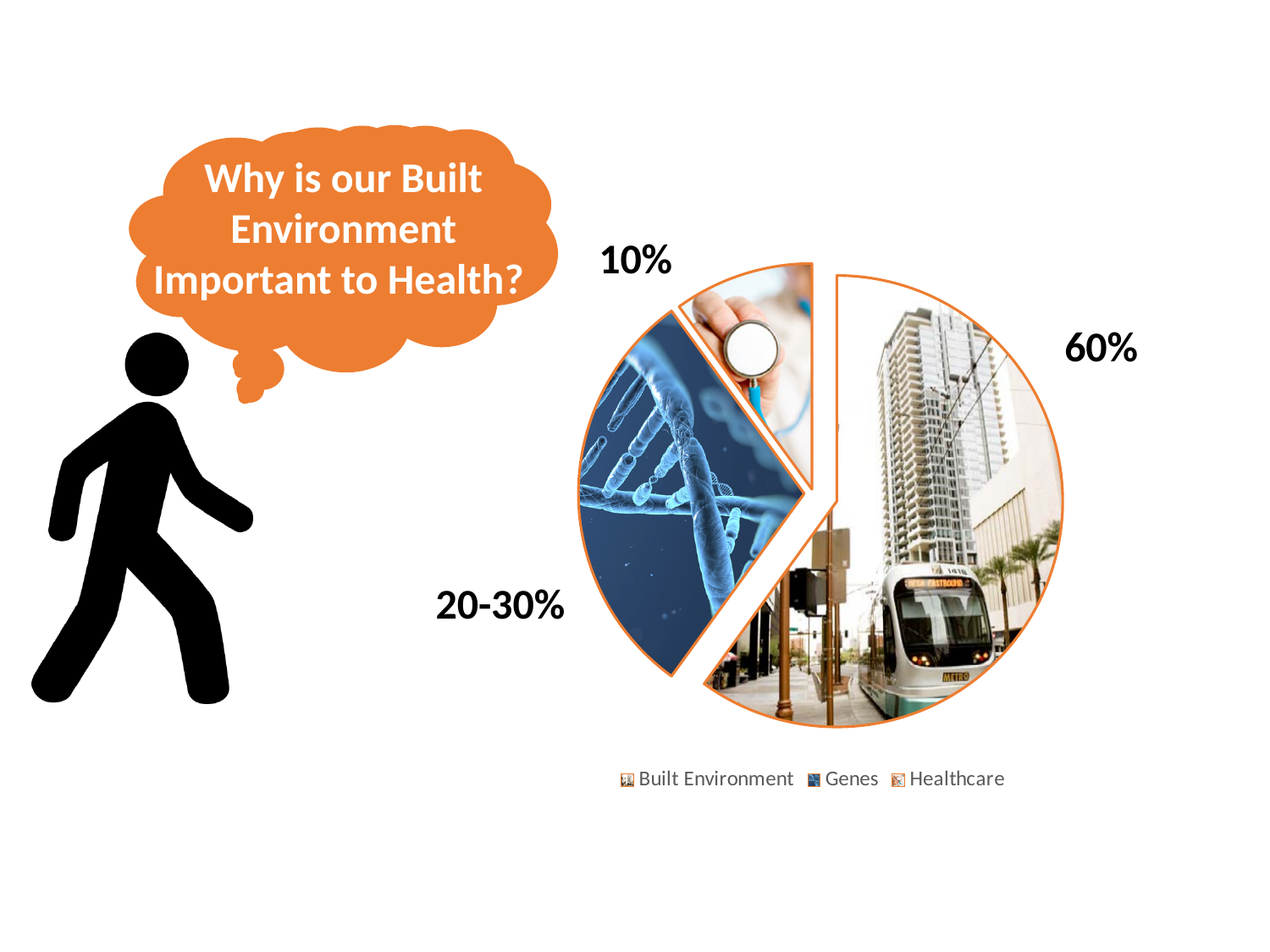
How many slices does the pie chart have? 3 Which category has the smallest slice of the pie? Healthcare What is the difference between the Built Environment value and the Healthcare value? 50% What is the value shown for Built Environment? 60% Which is larger, the slice for Built Environment or the slice for Healthcare? Built Environment What is the value shown for Genes? 20-30% What is the value shown for Healthcare? 10% Which is larger, the slice for Genes or the slice for Healthcare? Genes What kind of chart is shown on the slide? Pie chart What are the three categories listed in the legend? Built Environment, Genes, Healthcare Which category has the largest slice of the pie? Built Environment How many entries does the legend list? 3